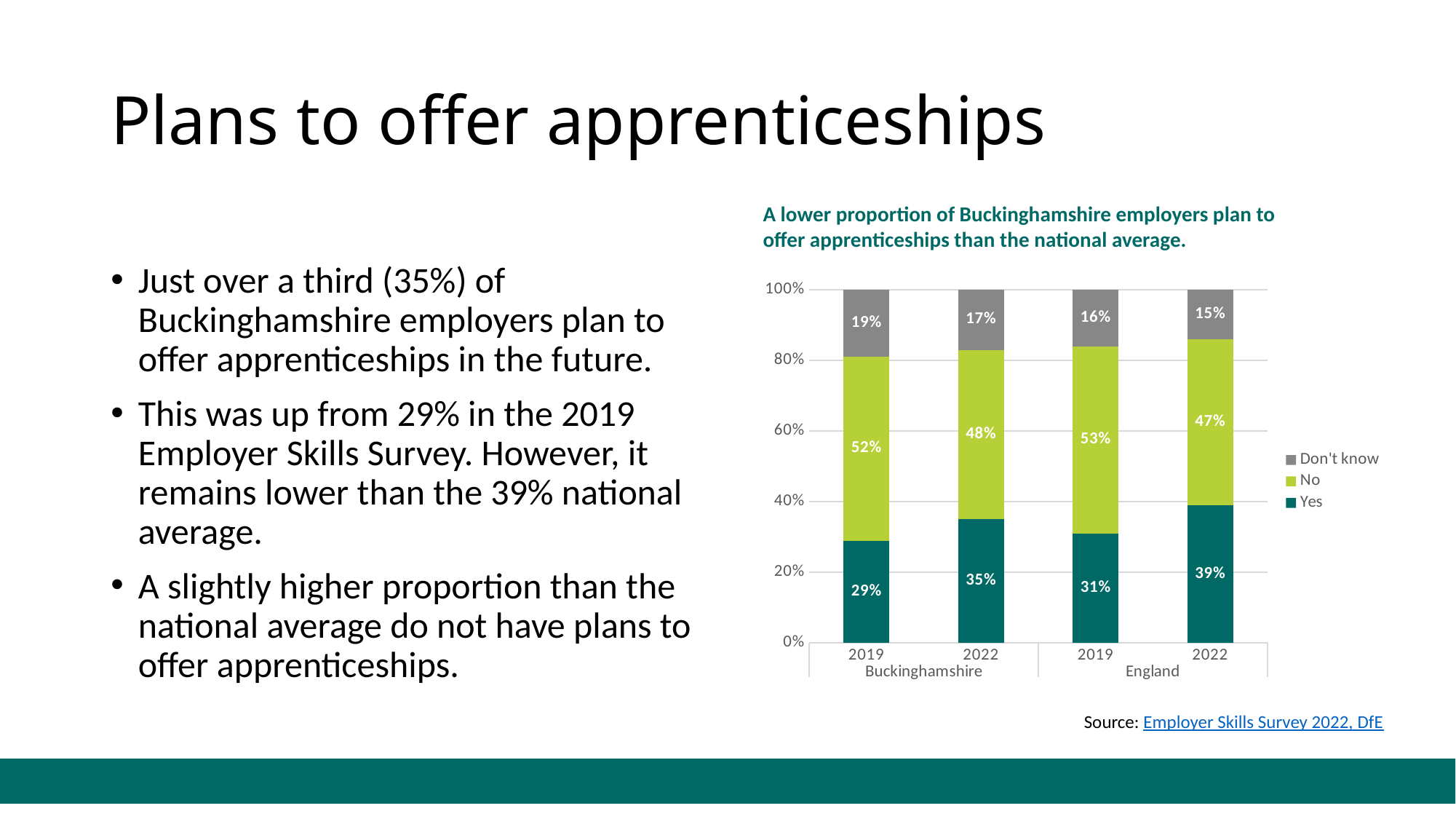
Which bar has the lowest 'Don't know' value? England 2022 What percentage of Buckinghamshire employers answered 'Yes' in 2022? 35% What kind of chart is shown? Stacked bar chart Which bar has the highest 'Yes' value? England 2022 How many series does the legend list? 3 How many bars are shown in the chart? 4 What is the difference between the 'Yes' values for Buckinghamshire in 2022 and 2019? 6 percentage points Which colour represents the 'Yes' series in the legend? Dark teal Which is larger: the 'No' value for Buckinghamshire 2022 or England 2022? Buckinghamshire 2022 What is the 'Don't know' value for Buckinghamshire in 2019? 19% Does the 'Yes' value for England rise or fall from 2019 to 2022? Rise What is the 'No' value for England in 2019? 53%